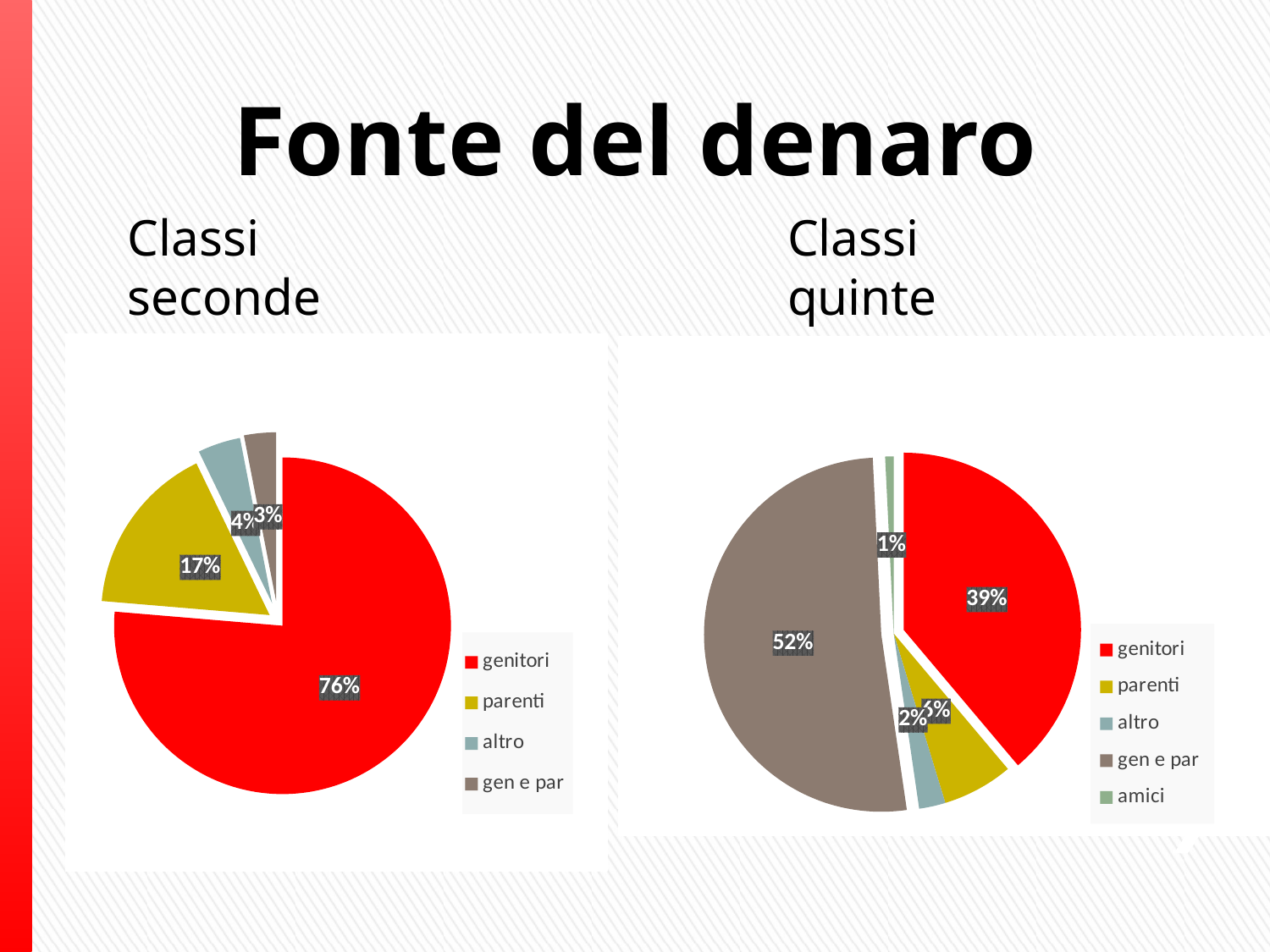
In the Classi seconde chart, which category has the largest slice? genitori In the Classi seconde chart, what percentage is shown for parenti? 17% How many categories does the legend of the Classi quinte chart list? 5 In the Classi quinte chart, which category has the smallest slice? amici In the Classi quinte chart, what percentage is shown for genitori? 39% In the Classi seconde chart, what share of the pie is genitori? 76% In the Classi quinte chart, what percentage is shown for amici? 1% In the Classi quinte chart, which is larger, genitori or gen e par? gen e par In the Classi seconde chart, what is the difference between the genitori and parenti shares? 59% What type of chart is used for Classi seconde? pie chart In the Classi seconde chart, what percentage is shown for altro? 4% In the Classi quinte chart, what share of the pie is gen e par? 52%